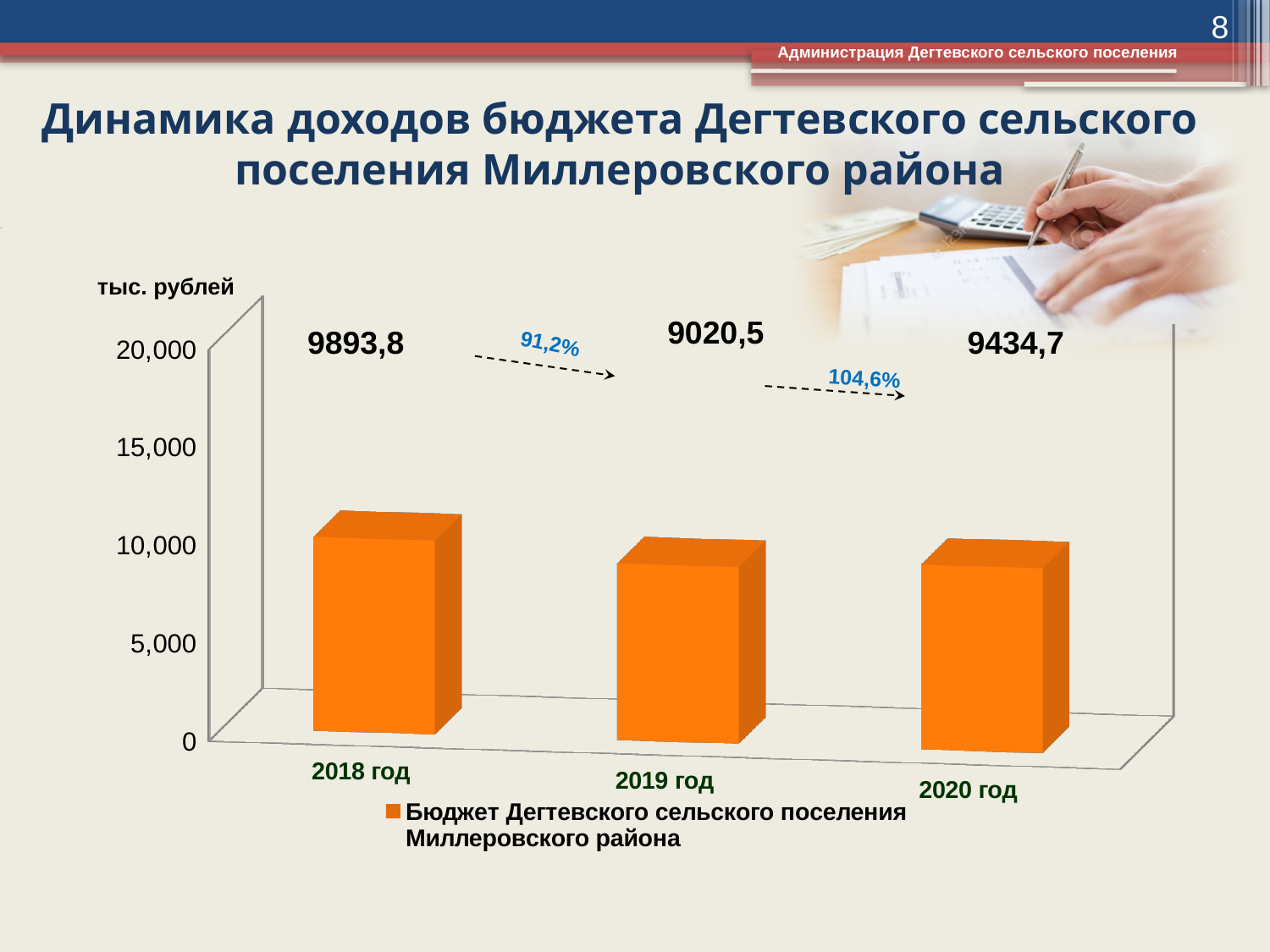
How many years are shown on the chart? 3 Is the value for 2019 год greater or less than 10,000? less What is the value for 2019 год? 9020,5 Which is larger, the value for 2018 год or the value for 2020 год? 2018 год What is the difference between the values for 2018 год and 2019 год? 873,3 What is the value for 2020 год? 9434,7 What is the difference between the values for 2020 год and 2019 год? 414,2 What unit is given for the vertical axis of the chart? тыс. рублей What kind of chart is shown on the slide? bar chart Which year has the highest value? 2018 год What is the value for 2018 год? 9893,8 Which year has the lowest value? 2019 год